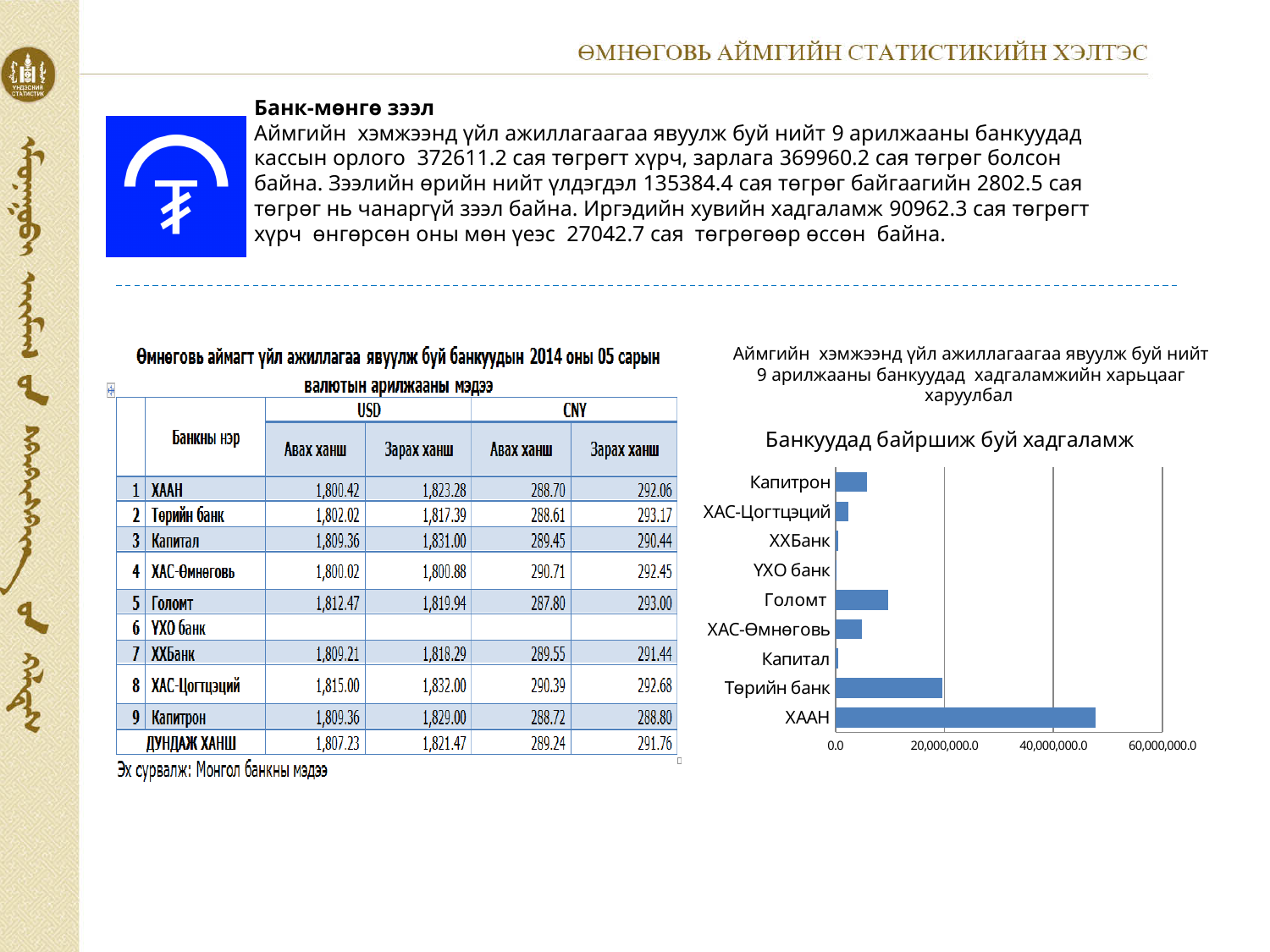
Which is larger, the value for Голомт or the value for Капитрон? Голомт Is the value for ХААН greater or less than 40,000,000.0? greater Is the value for Капитрон greater or less than 20,000,000.0? less What is the highest tick value shown on the horizontal axis of the chart? 60,000,000.0 How many banks are listed as categories in the chart? 9 Which is larger, the value for ХААН or the value for Төрийн банк? ХААН Is the value for Голомт greater or less than 20,000,000.0? less What kind of chart is shown on the slide? bar chart Which bank has the highest value in the chart? ХААН Which is larger, the value for Төрийн банк or the value for Голомт? Төрийн банк What is the title of the chart on the slide? Банкуудад байршиж буй хадгаламж